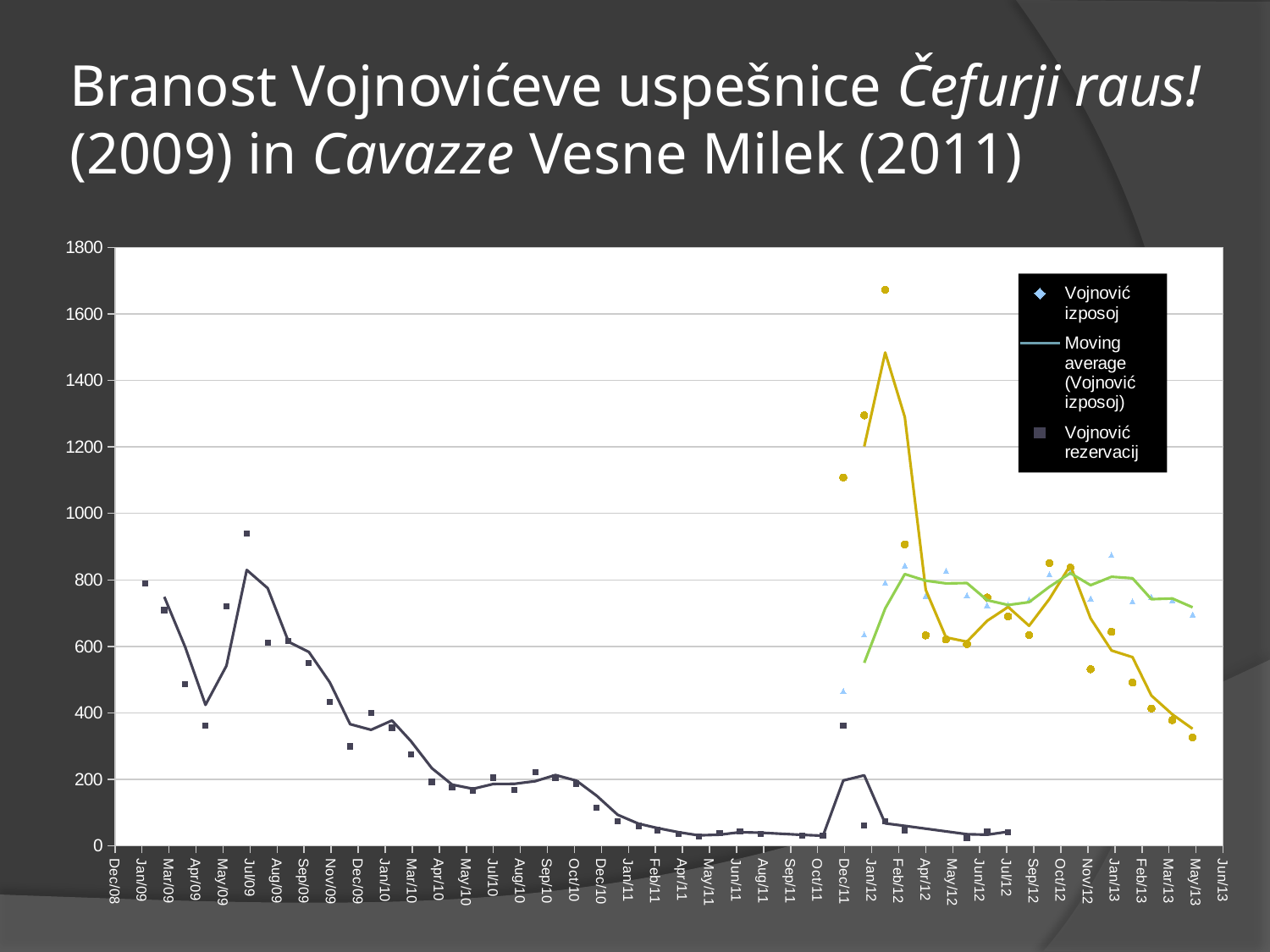
In which month does the Vojnović rezervacij series reach its highest value? Jul/09 Which is larger for Vojnović rezervacij: the value for Jul/09 or the value for Apr/09? Jul/09 What is the first month label on the horizontal axis? Dec/08 Do the gold-coloured data points rise or fall between Feb/12 and May/13? fall Is the Vojnović rezervacij value for Jun/11 greater or less than 200? less Do the Vojnović rezervacij values rise or fall between Jul/09 and Jan/11? fall What kind of chart is shown on the slide? line chart Is the gold-coloured data point for May/13 greater or less than 400? less Is the Vojnović rezervacij value for Jul/09 greater or less than 800? greater What is the highest value shown on the vertical axis? 1800